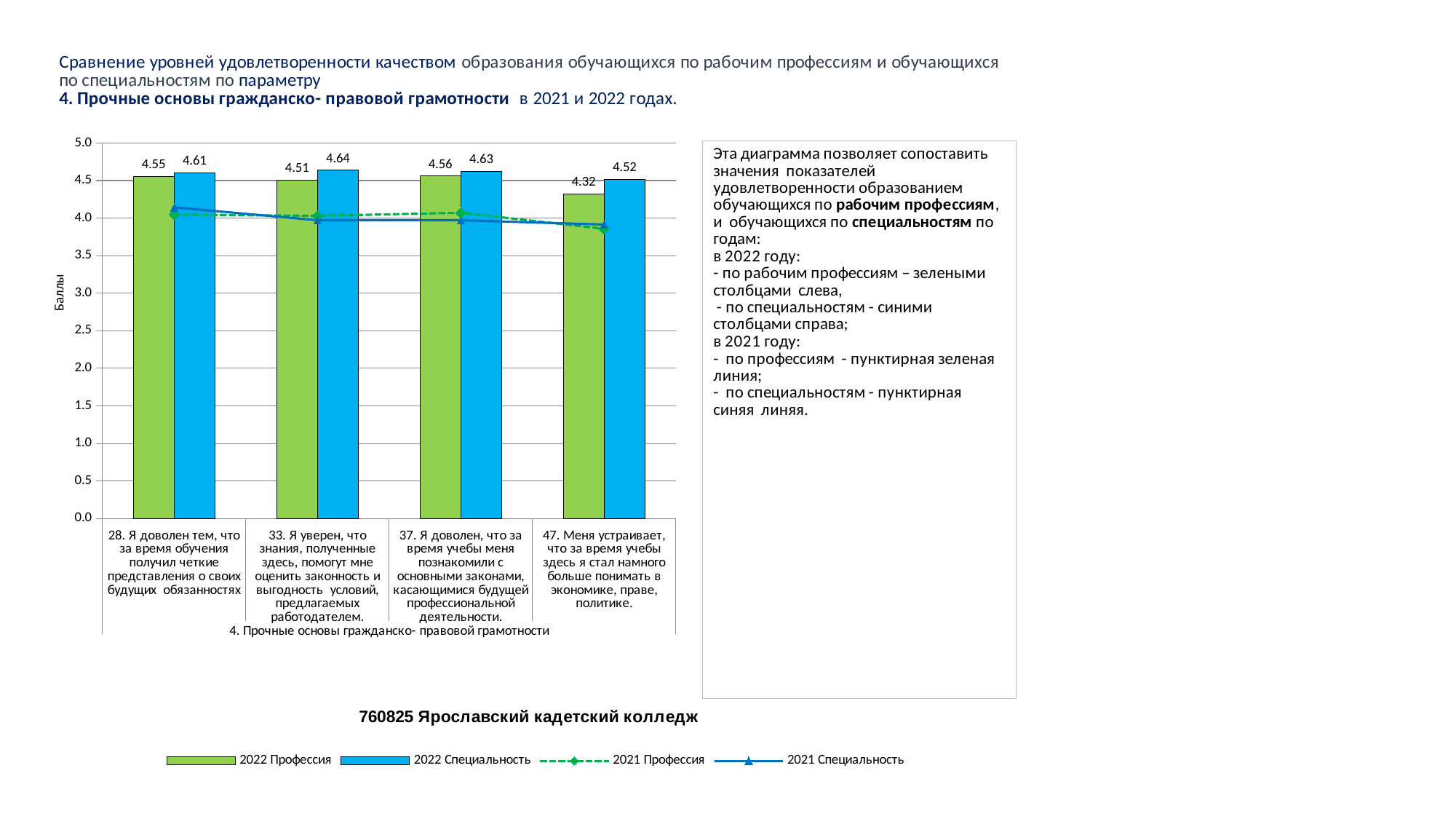
For item 37, which is larger: the 2022 Профессия bar or the 2022 Специальность bar? 2022 Специальность What is the value of the 2022 Специальность bar for item 33 (Я уверен, что знания, полученные здесь, помогут мне оценить законность и выгодность условий, предлагаемых работодателем)? 4.64 Is the 2021 Профессия line value for item 47 greater or less than 4.0? less What is the value of the 2022 Профессия bar for item 47 (Меня устраивает, что за время учебы здесь я стал намного больше понимать в экономике, праве, политике)? 4.32 How many survey items (categories) are shown on the x axis? 4 Which item has the lowest 2022 Профессия bar? 47. Меня устраивает, что за время учебы здесь я стал намного больше понимать в экономике, праве, политике. What is the value of the 2022 Профессия bar for item 28 (Я доволен тем, что за время обучения получил четкие представления о своих будущих обязанностях)? 4.55 What kind of chart is shown on the slide? Combined bar and line chart Which item has the highest 2022 Специальность bar? 33. Я уверен, что знания, полученные здесь, помогут мне оценить законность и выгодность условий, предлагаемых работодателем. What is the label of the vertical axis? Баллы What is the difference between the 2022 Специальность and 2022 Профессия bars for item 47? 0.20 How many series does the legend list? 4